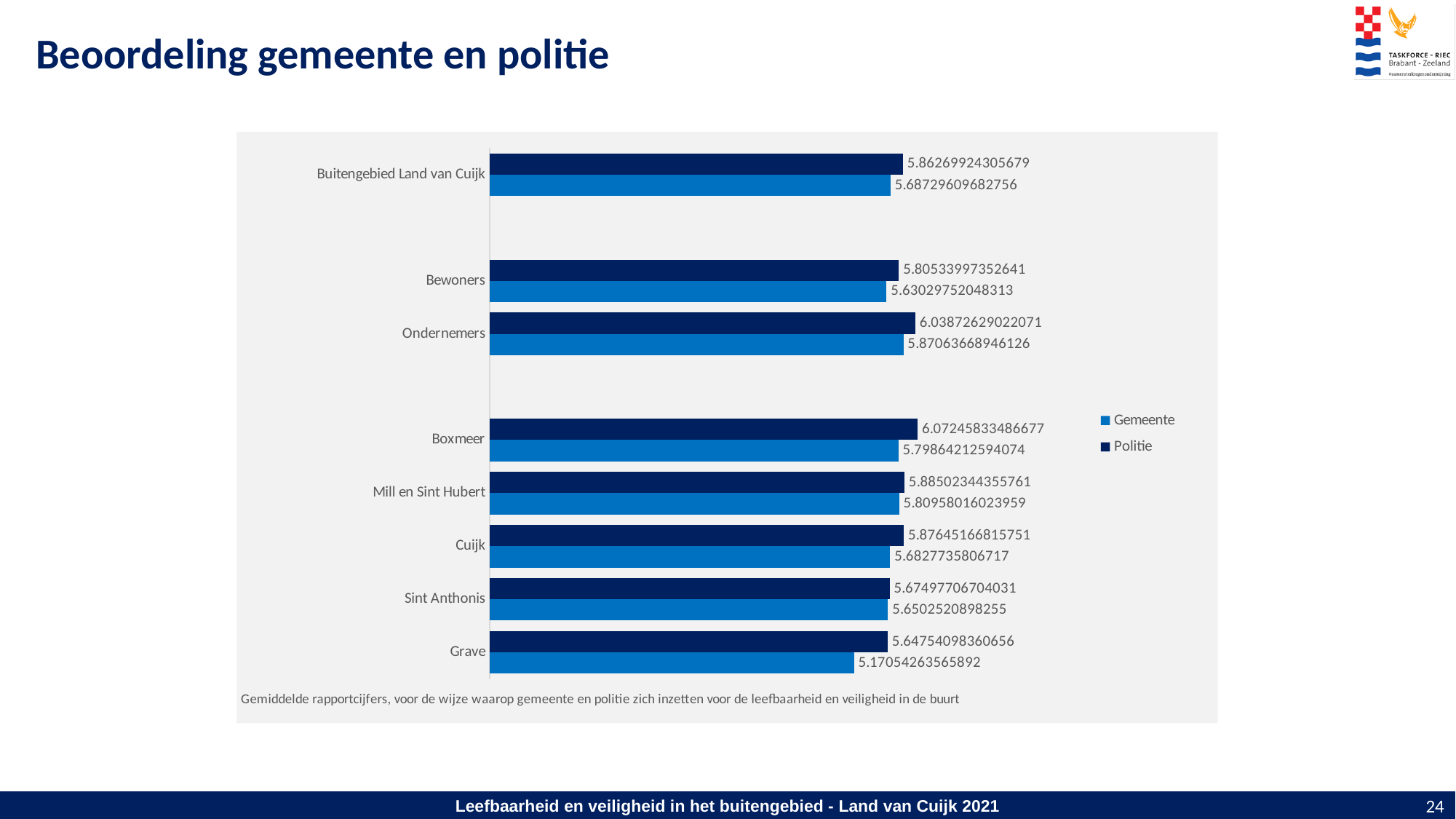
What is the Gemeente value for Ondernemers? 5.87063668946126 Which series is shown in dark blue in the legend? Politie What type of chart is shown on the slide? bar chart Which category has the highest Politie value? Boxmeer How many series does the legend list? 2 Which category has the highest Gemeente value? Ondernemers What is the Politie value for Sint Anthonis? 5.67497706704031 For Grave, which is larger: the Gemeente value or the Politie value? Politie What is the Gemeente value for Grave? 5.17054263565892 What is the Politie value for Boxmeer? 6.07245833486677 How many categories are shown on the chart? 8 Which category has the lowest Gemeente value? Grave